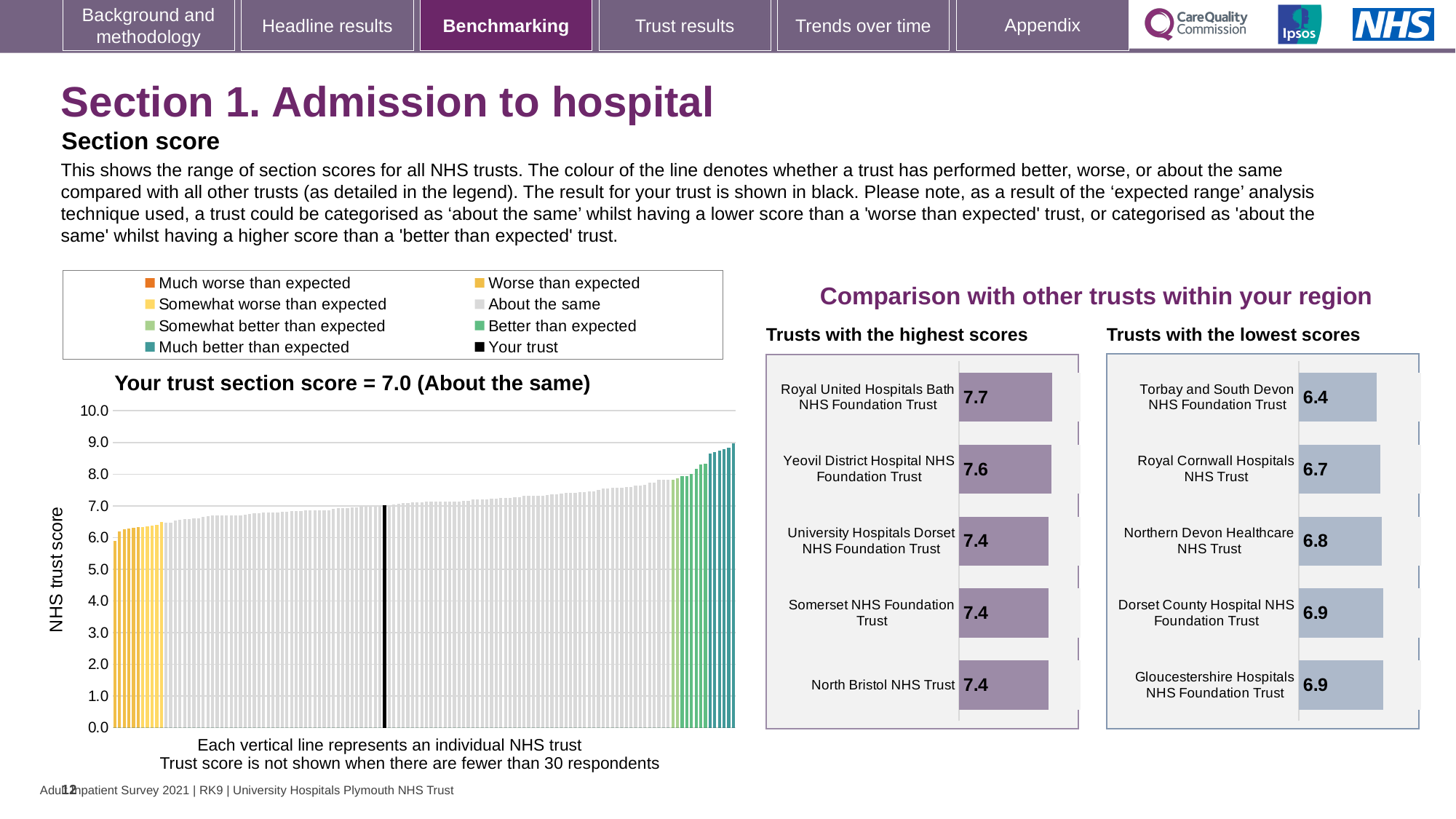
How many entries does the legend above the 'Your trust section score' chart list? 8 On the 'Trusts with the highest scores' chart, which trust has the highest score? Royal United Hospitals Bath NHS Foundation Trust On the 'Trusts with the highest scores' chart, what is the difference between the scores of Royal United Hospitals Bath NHS Foundation Trust and Yeovil District Hospital NHS Foundation Trust? 0.1 What kind of chart is the 'Your trust section score' chart? bar chart On the 'Your trust section score' chart, is the value of the rightmost bar greater or less than 8.0? greater On the 'Trusts with the lowest scores' chart, what is the score for Torbay and South Devon NHS Foundation Trust? 6.4 On the 'Your trust section score' chart, what is the section score for your trust? 7.0 On the 'Trusts with the highest scores' chart, what is the score for Royal United Hospitals Bath NHS Foundation Trust? 7.7 On the 'Your trust section score' chart, do the values rise or fall from left to right along the x axis? rise On the 'Your trust section score' chart, what colour is the bar for your trust? black On the 'Trusts with the lowest scores' chart, which trust has the lowest score? Torbay and South Devon NHS Foundation Trust How many trusts are shown on the 'Trusts with the lowest scores' chart? 5